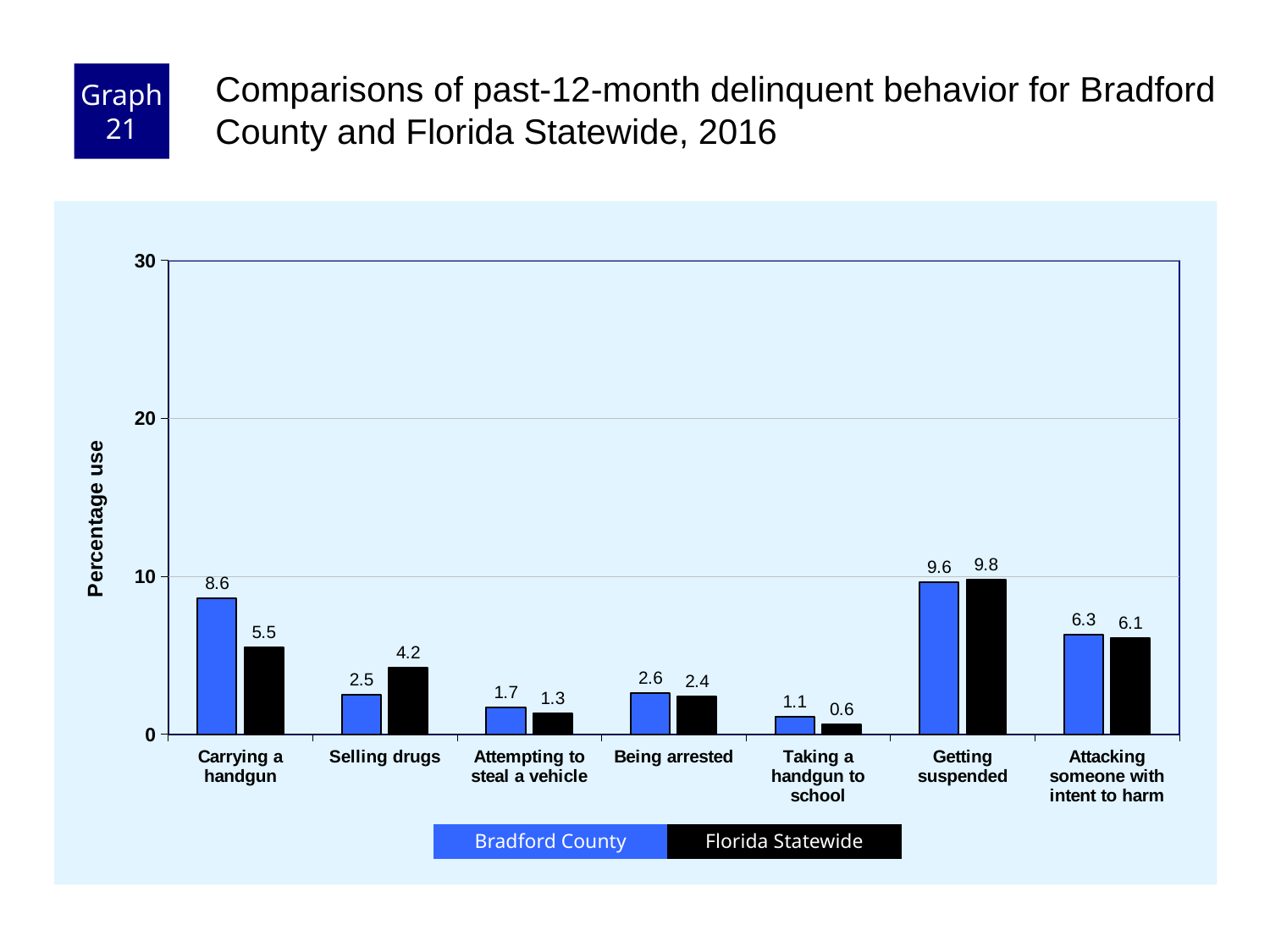
What is the difference between the Bradford County and Florida Statewide values for Carrying a handgun? 3.1 What is the Bradford County value for Carrying a handgun? 8.6 Is the Bradford County value for Getting suspended greater or less than 10? less What is the Florida Statewide value for Selling drugs? 4.2 What kind of chart is shown on the slide? bar chart How many categories are shown on the x axis? 7 What is the label of the y axis? Percentage use Which category has the highest Florida Statewide value? Getting suspended Which category has the lowest Bradford County value? Taking a handgun to school What is the Bradford County value for Taking a handgun to school? 1.1 How many series does the legend list? 2 Which is larger for Selling drugs: Bradford County or Florida Statewide? Florida Statewide